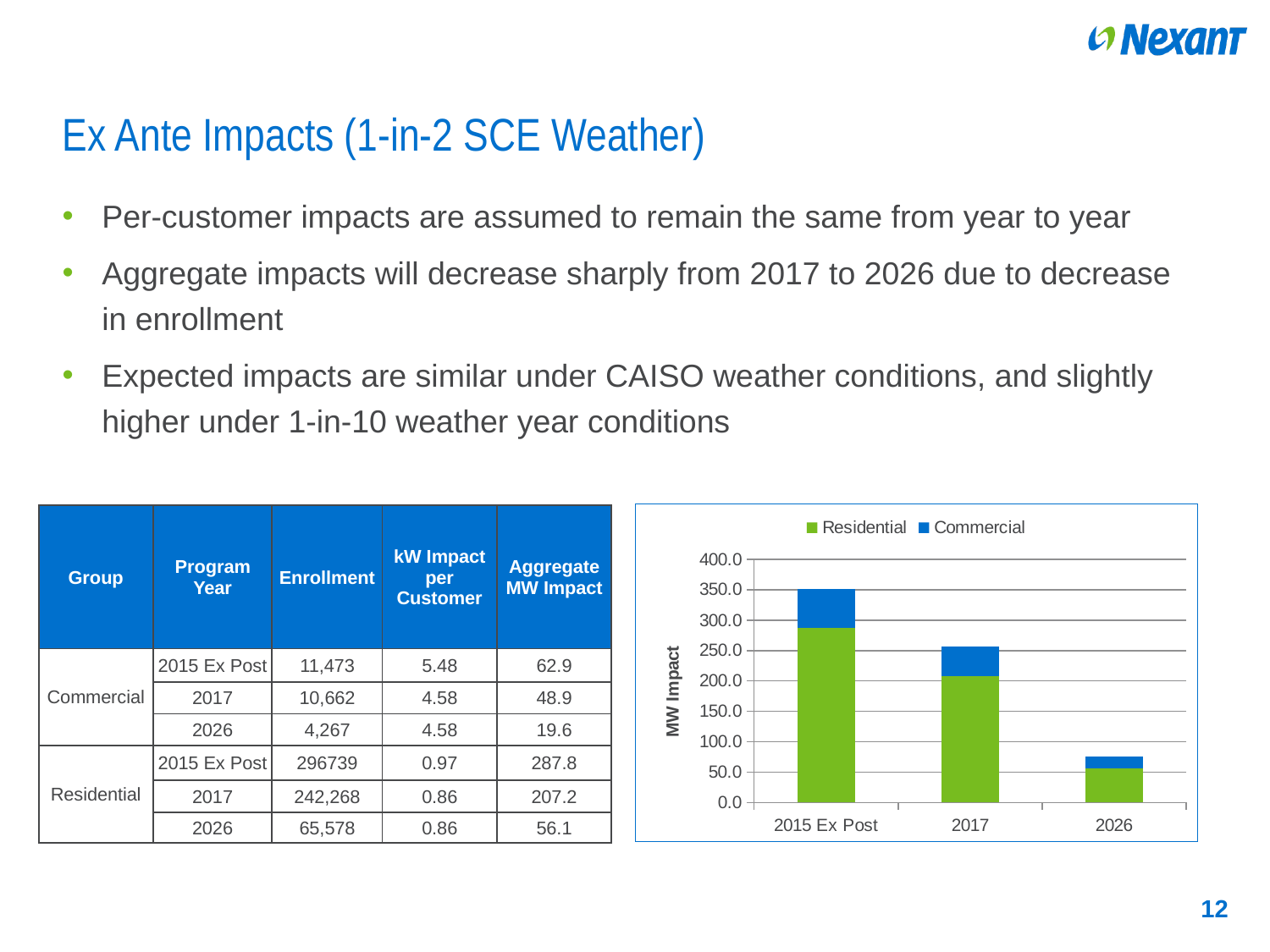
In 2017, which series has the larger MW impact, Residential or Commercial? Residential How many categories are shown on the x axis of the chart? 3 Is the total stacked value for 2017 greater or less than 300.0? less Is the total stacked value for 2026 greater or less than 100.0? less Do the total MW impacts rise or fall from 2015 Ex Post to 2026? Fall Is the Residential value for 2015 Ex Post greater or less than 250.0? greater How many series does the chart's legend list? 2 What is the label on the chart's vertical axis? MW Impact Which category has the highest total MW impact? 2015 Ex Post What kind of chart is shown on the slide? Stacked bar chart Which category has the lowest total MW impact? 2026 Which colour represents the Residential series in the chart? Green